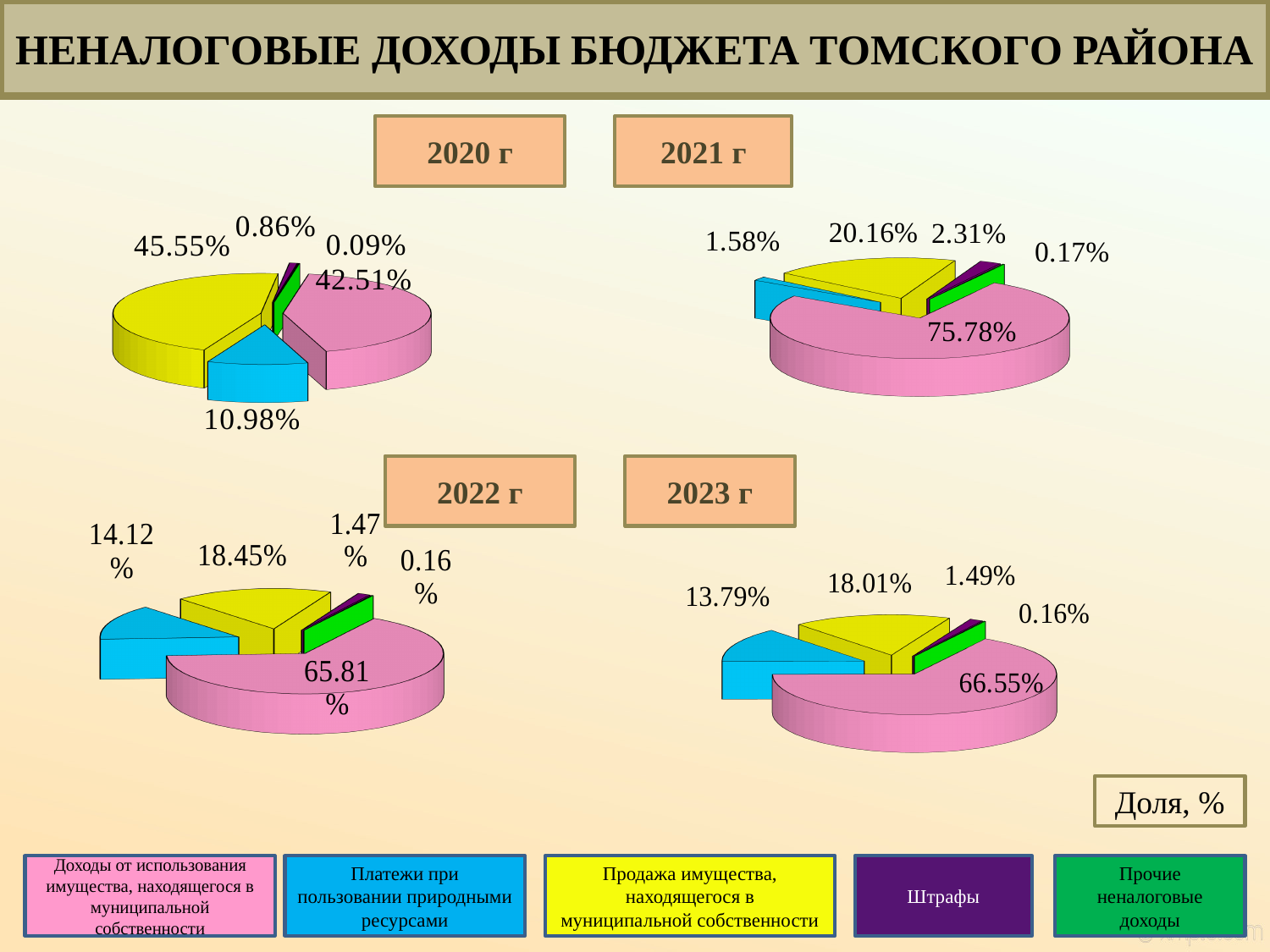
How many categories does the legend at the bottom of the slide list? 5 What type of chart is used for each year on the slide? Pie chart In the 2020 pie chart, which category has the smallest share? Прочие неналоговые доходы (0.09%) In the 2022 pie chart, what share is shown for payments for use of natural resources (blue slice)? 14.12% In the 2020 pie chart, which is larger: the yellow slice (45.55%) or the pink slice (42.51%)? The yellow slice (45.55%) In the 2023 pie chart, what is the difference between the pink slice (66.55%) and the yellow slice (18.01%)? 48.54% In the 2023 pie chart, what share is shown for sale of municipal property (yellow slice)? 18.01% Which colour represents 'Штрафы' (fines) in the legend? Purple In the 2021 pie chart, what share is shown for income from use of municipal property (pink slice)? 75.78% In the 2020 pie chart, what share is shown for the largest slice (yellow, sale of municipal property)? 45.55% How many pie charts are shown on the slide? 4 In the 2021 pie chart, which category has the largest share? Доходы от использования имущества, находящегося в муниципальной собственности (75.78%)